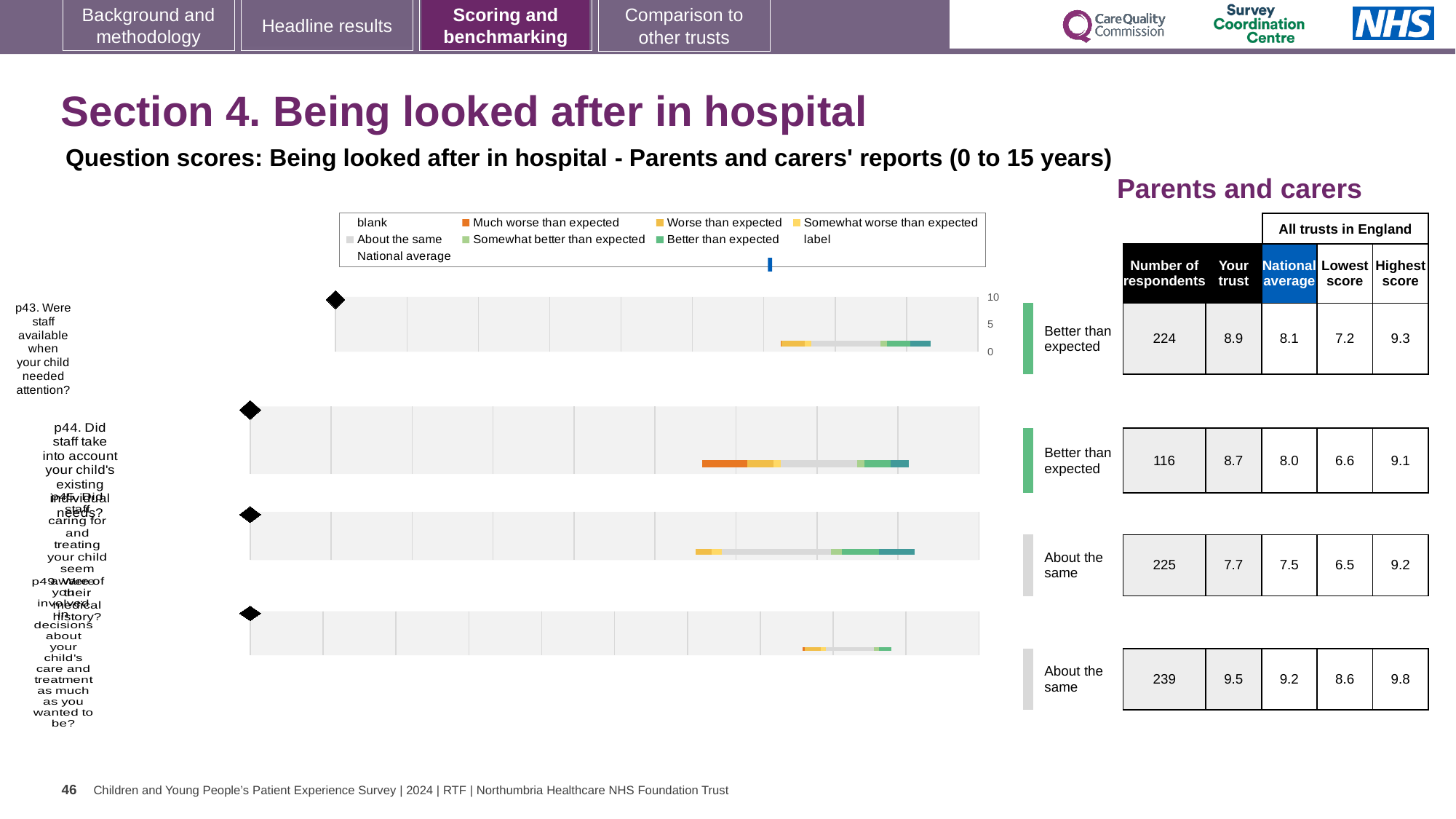
In the table beside the chart, what is the difference between the 'Your trust' score and the national average for p43? 0.8 In the table beside the chart, what is the national average for p44 (Did staff take into account your child's existing individual needs?)? 8.0 What benchmark category is shown for p43 in the chart's results column? Better than expected What kind of chart is shown on the slide? bar chart In the table beside the chart, is the 'Your trust' score for p45 higher or lower than the national average for p45? higher How many question categories (rows) are plotted in the chart? 4 In the table beside the chart, what is the 'Your trust' score for p43 (Were staff available when your child needed attention?)? 8.9 In the table beside the chart, which question row has the lowest 'Your trust' score? p45 Which colour does the chart legend use for 'Better than expected'? teal In the table beside the chart, which question row has the highest 'Your trust' score? p49 Which colour does the chart legend use for 'Much worse than expected'? orange In the table beside the chart, how many respondents answered p49 (Were you involved in decisions about your child's care and treatment as much as you wanted to be?)? 239